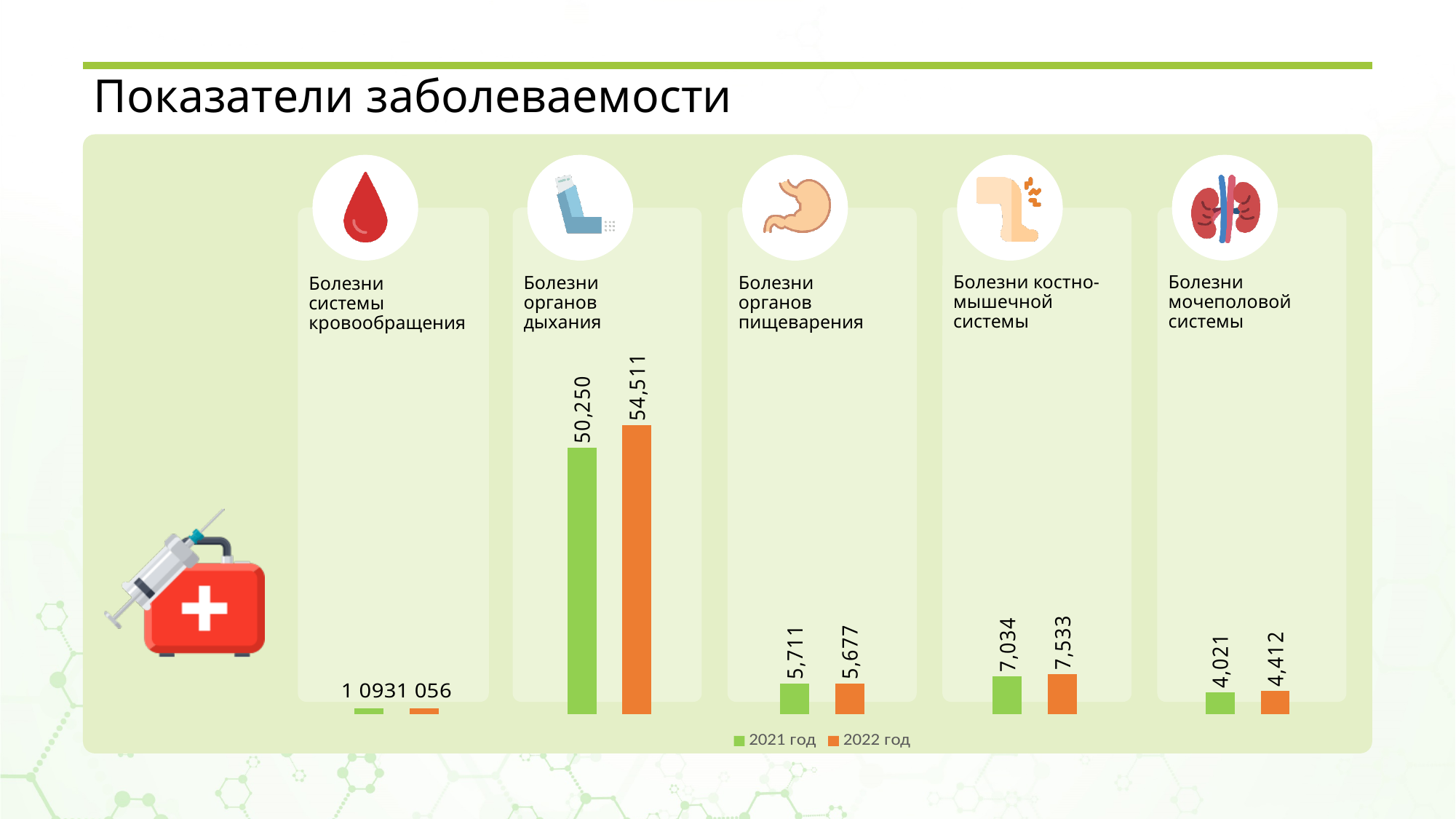
What is the value for Болезни органов дыхания in 2021 год? 50,250 What is the difference between the 2022 год and 2021 год values for Болезни костно-мышечной системы? 499 What is the value for Болезни мочеполовой системы in 2021 год? 4,021 Which category has the highest value in 2022 год? Болезни органов дыхания What is the value for Болезни органов дыхания in 2022 год? 54,511 How many disease categories are shown in the chart? 5 What kind of chart is shown on the slide? Bar chart What is the value for Болезни костно-мышечной системы in 2022 год? 7,533 What is the difference between the 2022 год and 2021 год values for Болезни органов дыхания? 4,261 Which category has the lowest values in both years? Болезни системы кровообращения How many series does the legend list? 2 For Болезни органов пищеварения, which year has the larger value, 2021 год or 2022 год? 2021 год